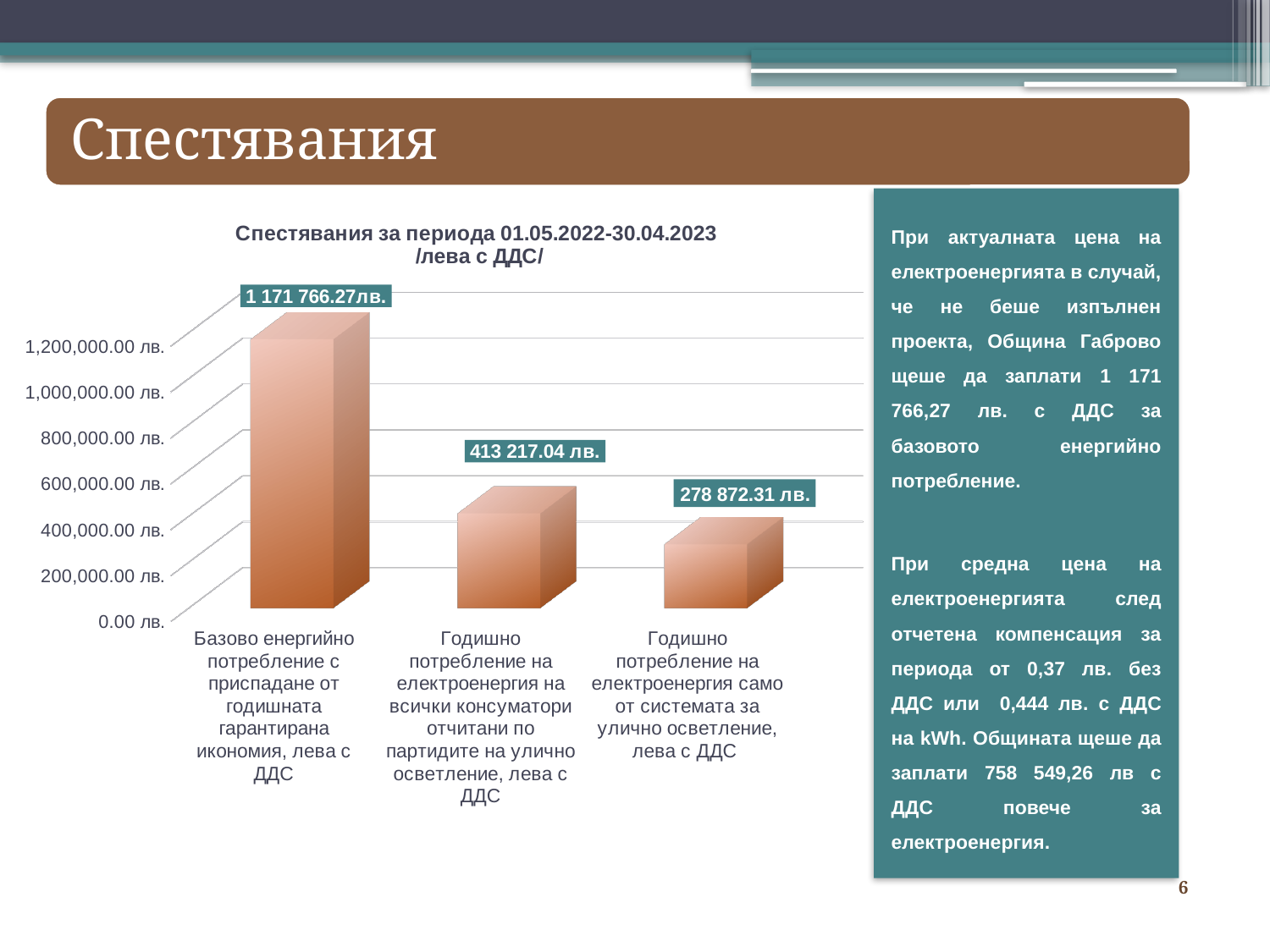
Which is larger: the value for 'Годишно потребление на електроенергия на всички консуматори отчитани по партидите на улично осветление' or the value for 'Годишно потребление на електроенергия само от системата за улично осветление'? Годишно потребление на електроенергия на всички консуматори отчитани по партидите на улично осветление What is the value of the bar for 'Базово енергийно потребление с приспадане от годишната гарантирана икономия, лева с ДДС'? 1 171 766.27лв. What is the difference between the value for 'Базово енергийно потребление с приспадане от годишната гарантирана икономия' and the value for 'Годишно потребление на електроенергия на всички консуматори отчитани по партидите на улично осветление'? 758 549.23 лв. What is the title of the chart? Спестявания за периода 01.05.2022-30.04.2023 /лева с ДДС/ Is the value for 'Годишно потребление на електроенергия само от системата за улично осветление' greater or less than 400,000.00 лв.? less Which category has the highest value in the chart? Базово енергийно потребление с приспадане от годишната гарантирана икономия, лева с ДДС What is the value of the bar for 'Годишно потребление на електроенергия на всички консуматори отчитани по партидите на улично осветление, лева с ДДС'? 413 217.04 лв. What is the value of the bar for 'Годишно потребление на електроенергия само от системата за улично осветление, лева с ДДС'? 278 872.31 лв. Which category has the lowest value in the chart? Годишно потребление на електроенергия само от системата за улично осветление, лева с ДДС What kind of chart is shown on the slide? bar chart How many categories are shown in the chart? 3 What is the difference between the value for 'Годишно потребление на електроенергия на всички консуматори отчитани по партидите на улично осветление' and the value for 'Годишно потребление на електроенергия само от системата за улично осветление'? 134 344.73 лв.